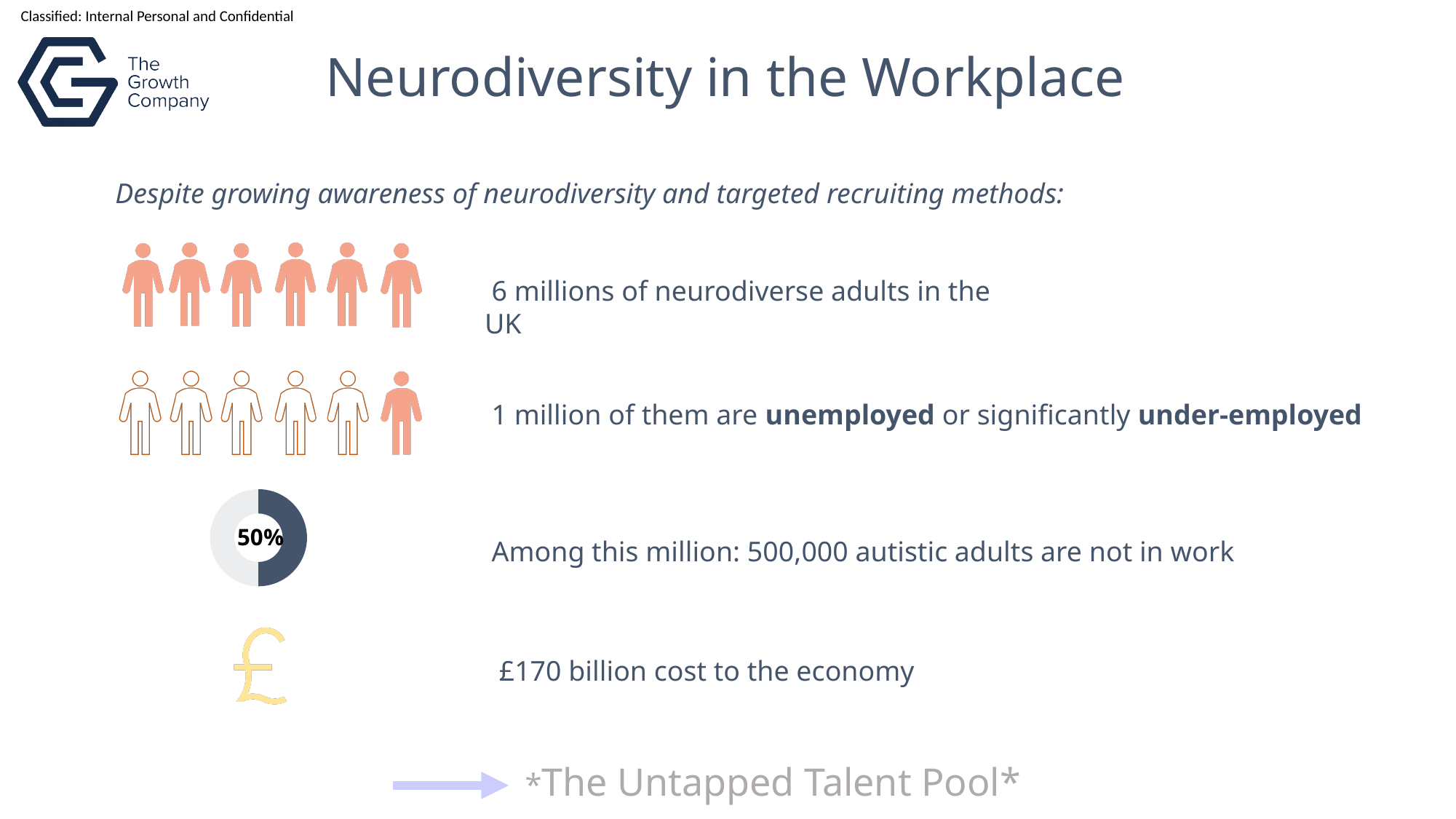
Is the dark segment of the donut chart greater or less than 25%? greater How many person icons are shown in the second row of the pictogram? 6 What share of the donut chart is filled with the dark colour? 50% How many of the neurodiverse adults are unemployed or significantly under-employed, according to the second pictogram? 1 million What kind of chart is the circular graphic next to the text about autistic adults not in work? Donut (pie) chart What cost to the economy is shown next to the pound sign icon? £170 billion How many autistic adults are not in work, according to the text beside the donut chart? 500,000 How many person icons are shown in the top row of the pictogram? 6 What percentage is shown in the centre of the donut chart? 50% In the second row of person icons, how many icons are filled in solid colour? 1 How many neurodiverse adults in the UK does the top pictogram represent? 6 millions What colour are the filled person icons in the pictogram? Orange (salmon)